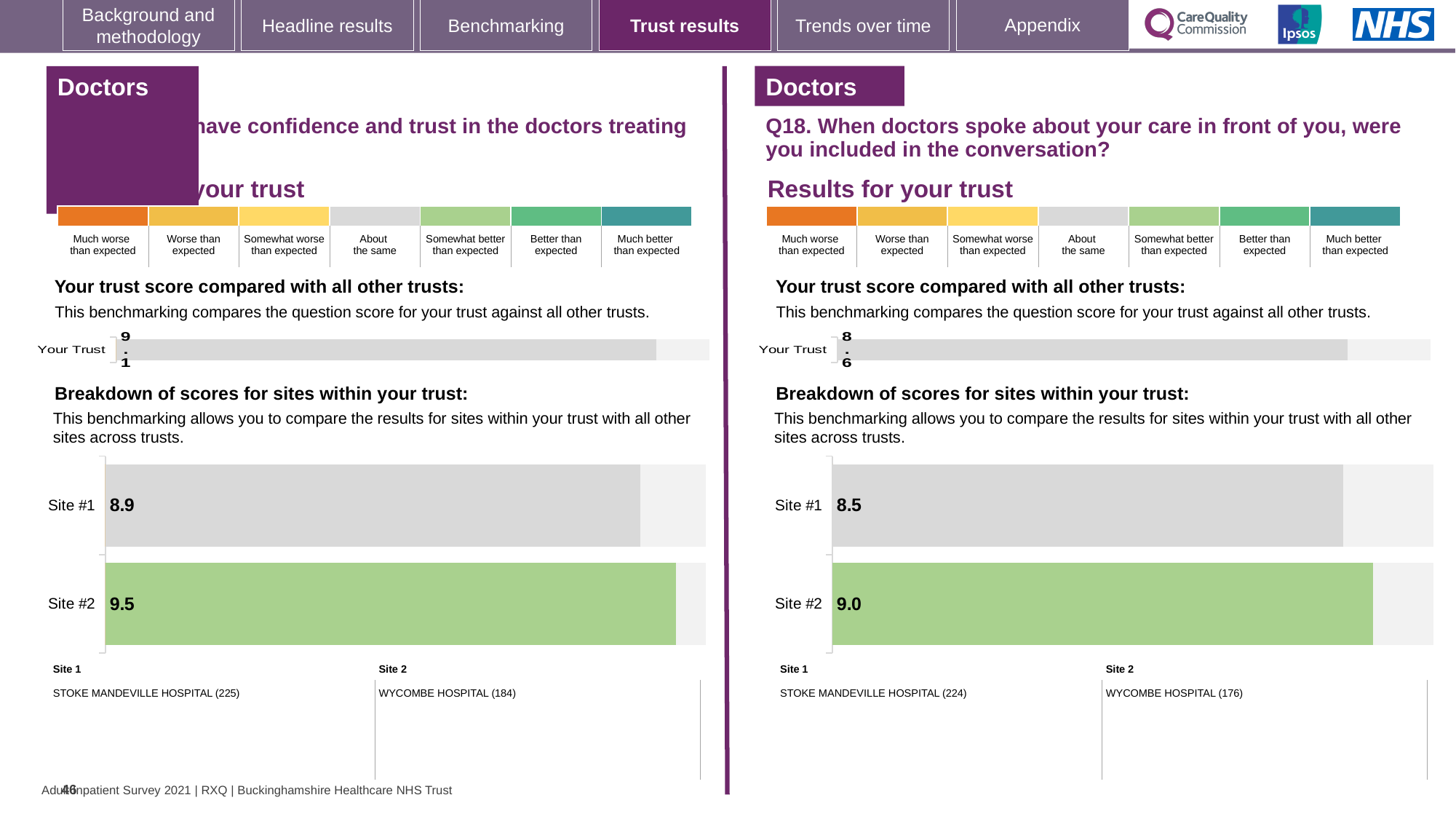
On the Q18 site breakdown chart (right-hand side), what is the difference between the Site #2 and Site #1 scores? 0.5 On the Q18 site breakdown chart (right-hand side), what is the score for Site #2? 9.0 On the left-hand site breakdown chart, what is the score for Site #2? 9.5 How many sites are shown on the Q18 site breakdown chart (right-hand side)? 2 On the Q18 site breakdown chart (right-hand side), what is the score for Site #1? 8.5 On the left-hand site breakdown chart, what is the score for Site #1? 8.9 On the Q18 site breakdown chart (right-hand side), which site has the lower score? Site #1 On the left-hand 'Your Trust' chart, what is the trust score shown? 9.1 On the left-hand site breakdown chart, what is the difference between the Site #2 and Site #1 scores? 0.6 On the Q18 'Your Trust' chart (right-hand side), what is the trust score shown? 8.6 On the left-hand site breakdown chart, which site has the higher score? Site #2 What type of chart is the left-hand site breakdown chart? Bar chart